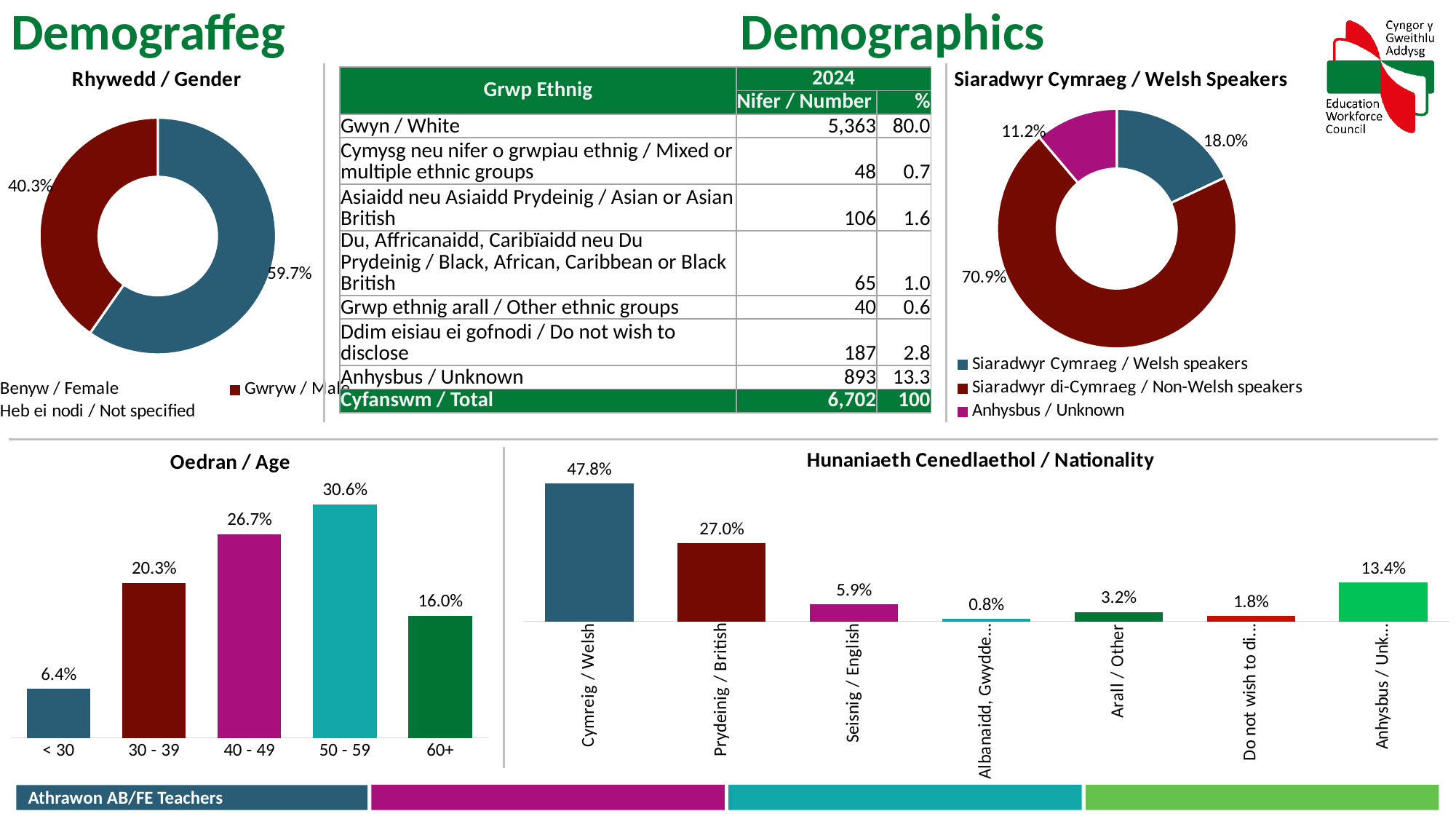
How many entries does the legend of the Siaradwyr Cymraeg / Welsh Speakers chart list? 3 How many age groups are shown in the Oedran / Age chart? 5 In the Hunaniaeth Cenedlaethol / Nationality chart, which is larger: Seisnig / English or Arall / Other? Seisnig / English In the Rhywedd / Gender chart, what is the value for Gwryw / Male? 40.3% In the Oedran / Age chart, which age group has the lowest value? < 30 In the Hunaniaeth Cenedlaethol / Nationality chart, what is the value for Prydeinig / British? 27.0% In the Siaradwyr Cymraeg / Welsh Speakers chart, what is the value for Anhysbus / Unknown? 11.2% In the Siaradwyr Cymraeg / Welsh Speakers chart, what share is Siaradwyr di-Cymraeg / Non-Welsh speakers? 70.9% In the Hunaniaeth Cenedlaethol / Nationality chart, which category has the highest value? Cymreig / Welsh In the Oedran / Age chart, what is the difference between the 40 - 49 and 30 - 39 values? 6.4% What kind of chart is the Hunaniaeth Cenedlaethol / Nationality chart? Bar chart In the Oedran / Age chart, what is the value for the 50 - 59 age group? 30.6%